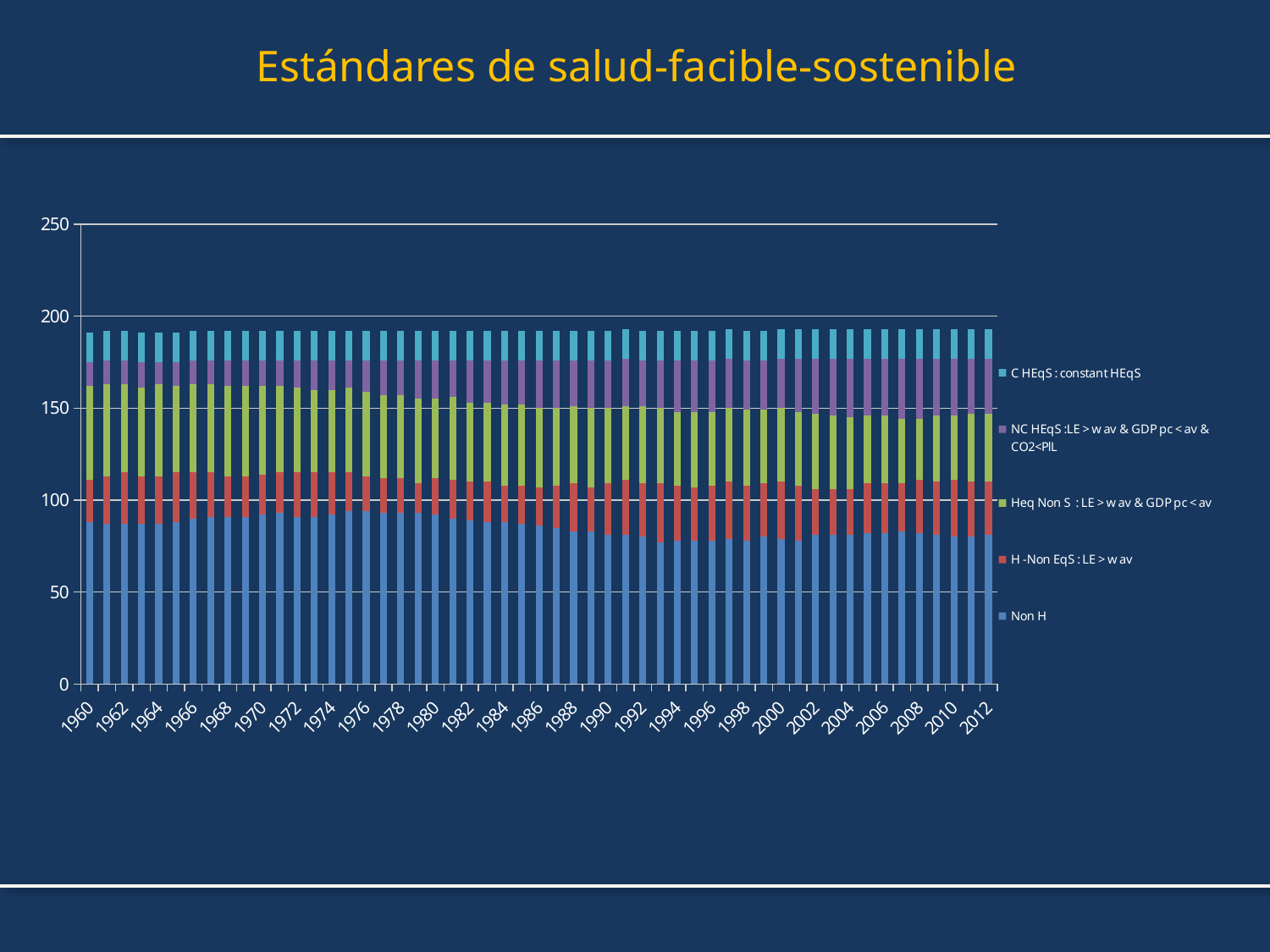
How many series does the legend list? 5 Is the value of the Non H series for 2012 greater or less than 100? less What is the first year shown on the x axis? 1960 Does the Non H series generally rise or fall from 1960 to 2012? fall Is the value of the Non H series for 1960 greater or less than 50? greater What kind of chart is shown on the slide? stacked bar chart Which series is shown at the bottom of each stacked bar? Non H Is the total height of the stacked bar for 2012 greater or less than 150? greater What is the title of the slide containing the chart? Estándares de salud-facible-sostenible What is the last year shown on the x axis? 2012 Which year has the larger Non H value, 1960 or 2012? 1960